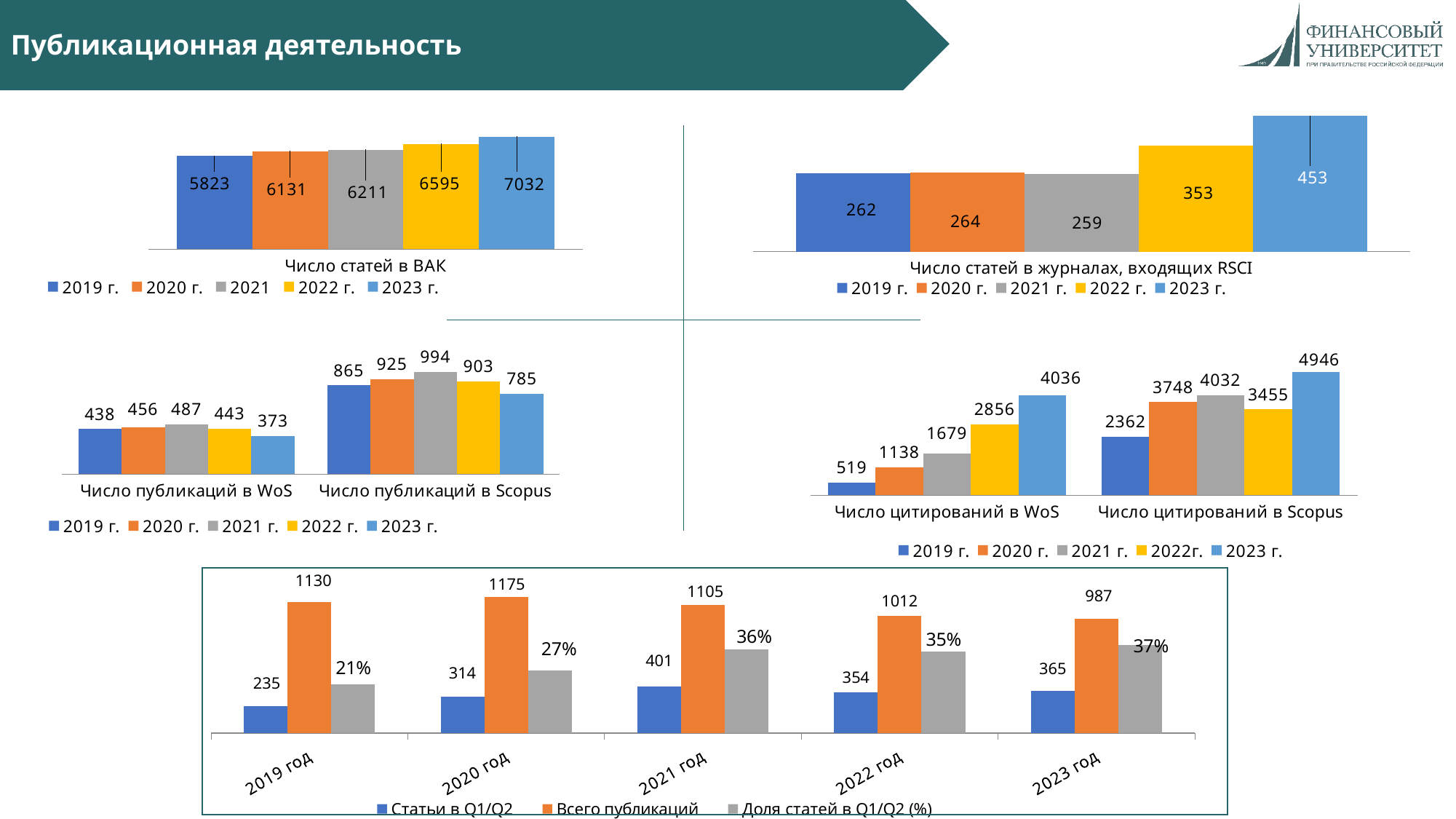
In the chart with 'Число публикаций в WoS' and 'Число публикаций в Scopus', what is the value for 2021 г. in 'Число публикаций в Scopus'? 994 What kind of chart is the bottom chart with years on the x axis? bar chart In the chart with 'Число цитирований в WoS' and 'Число цитирований в Scopus', how many series does the legend list? 5 In the chart 'Число статей в журналах, входящих RSCI', what is the difference between the 2023 г. and 2022 г. values? 100 In the chart 'Число статей в ВАК', do the values rise or fall from 2019 to 2023? rise In the chart with 'Число цитирований в WoS' and 'Число цитирований в Scopus', which is larger: 2021 г. in 'Число цитирований в Scopus' or 2023 г. in 'Число цитирований в WoS'? 2023 г. in Число цитирований в WoS In the chart 'Число статей в ВАК', what is the value for 2023 г.? 7032 In the chart 'Число статей в журналах, входящих RSCI', which year has the highest value? 2023 г. In the chart with 'Число публикаций в WoS' and 'Число публикаций в Scopus', which year has the lowest value for 'Число публикаций в WoS'? 2023 г. In the chart with 'Число цитирований в WoS' and 'Число цитирований в Scopus', what is the value for 2022г. in 'Число цитирований в WoS'? 2856 In the bottom chart with years on the x axis, what is the value of 'Всего публикаций' for 2020 год? 1175 In the bottom chart with years on the x axis, what is the value of 'Доля статей в Q1/Q2 (%)' for 2023 год? 37%